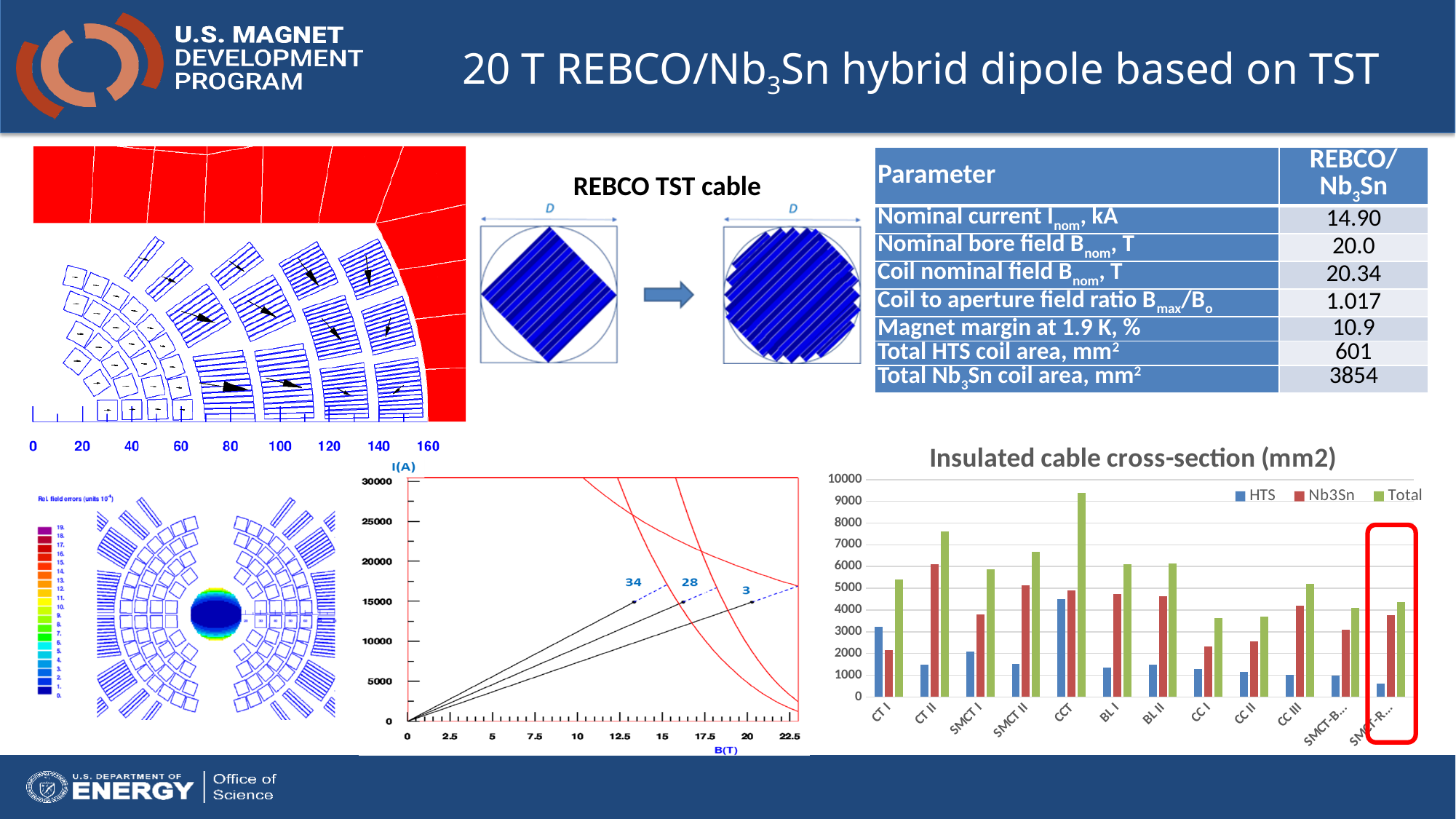
In the 'Insulated cable cross-section (mm2)' chart, which category has the highest HTS value? CCT How many categories are shown on the x axis of the 'Insulated cable cross-section (mm2)' chart? 12 In the 'Insulated cable cross-section (mm2)' chart, which category has the lowest HTS value? SMCT-R... What kind of chart is 'Insulated cable cross-section (mm2)'? bar chart In the 'Insulated cable cross-section (mm2)' chart, is the Nb3Sn value for CT I greater or less than 3000? less In the 'Insulated cable cross-section (mm2)' chart, which category has the highest Nb3Sn value? CT II In the 'Insulated cable cross-section (mm2)' chart, is the Total value for CCT greater or less than 9000? greater How many series does the legend of the 'Insulated cable cross-section (mm2)' chart list? 3 In the 'Insulated cable cross-section (mm2)' chart, which category has the highest Total value? CCT In the 'Insulated cable cross-section (mm2)' chart, which category is highlighted with a red box? SMCT-R... In the 'Insulated cable cross-section (mm2)' chart, is the HTS value for CT I greater or less than 3000? greater In the 'Insulated cable cross-section (mm2)' chart, which has the larger Total value, CT II or SMCT II? CT II